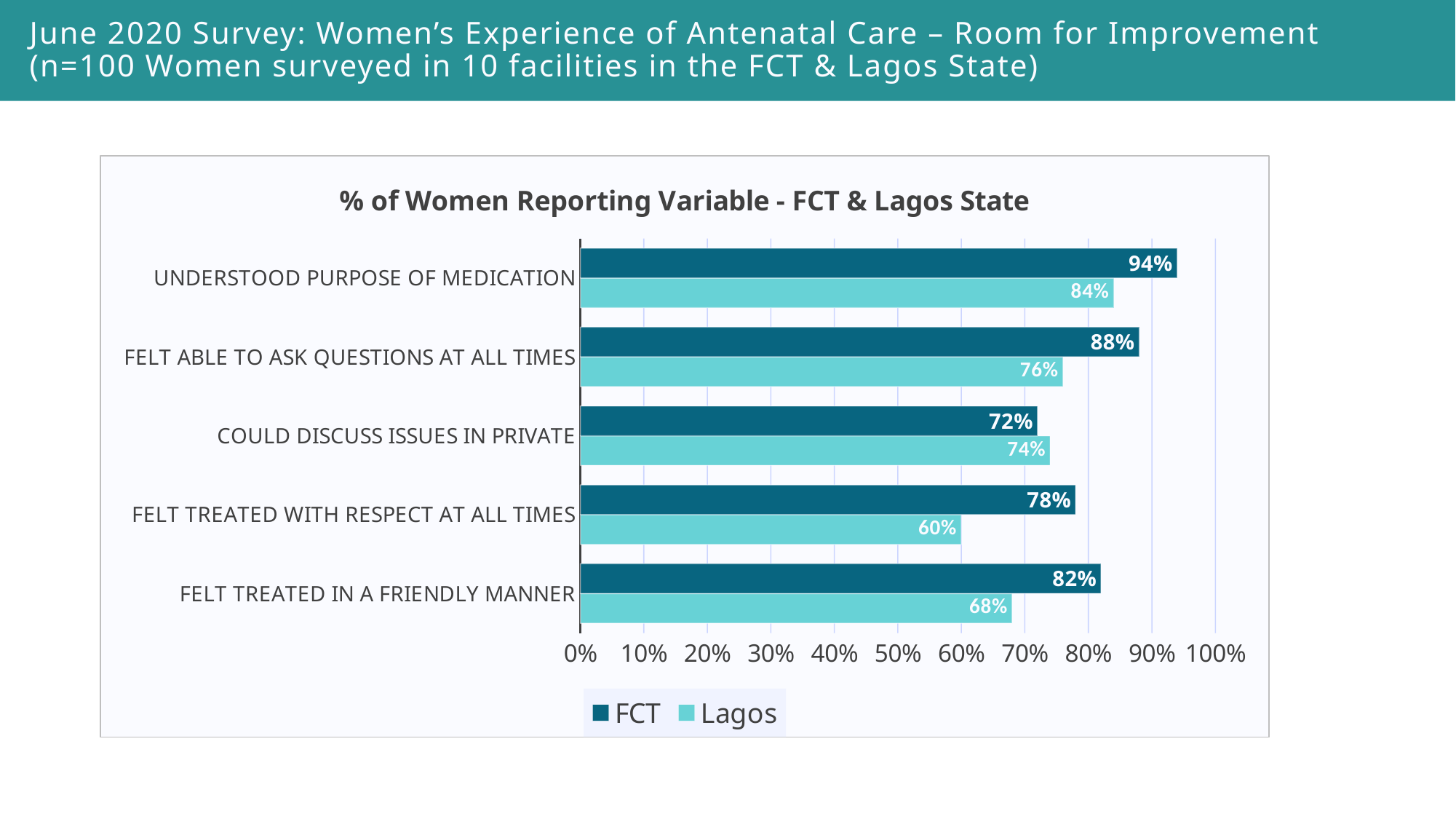
What percentage of women in Lagos reported feeling treated with respect at all times? 60% Which category has the highest FCT value? Understood purpose of medication How many series does the legend list? 2 What is the Lagos value for 'Felt able to ask questions at all times'? 76% What is the title of the chart? % of Women Reporting Variable - FCT & Lagos State Which series is shown in the darker teal colour? FCT What kind of chart is shown on the slide? Bar chart What percentage of women in the FCT reported that they understood the purpose of medication? 94% How many categories are shown on the chart? 5 Which category has the lowest Lagos value? Felt treated with respect at all times What is the difference between the FCT and Lagos values for 'Felt treated in a friendly manner'? 14% For 'Could discuss issues in private', which is larger, the FCT value or the Lagos value? Lagos